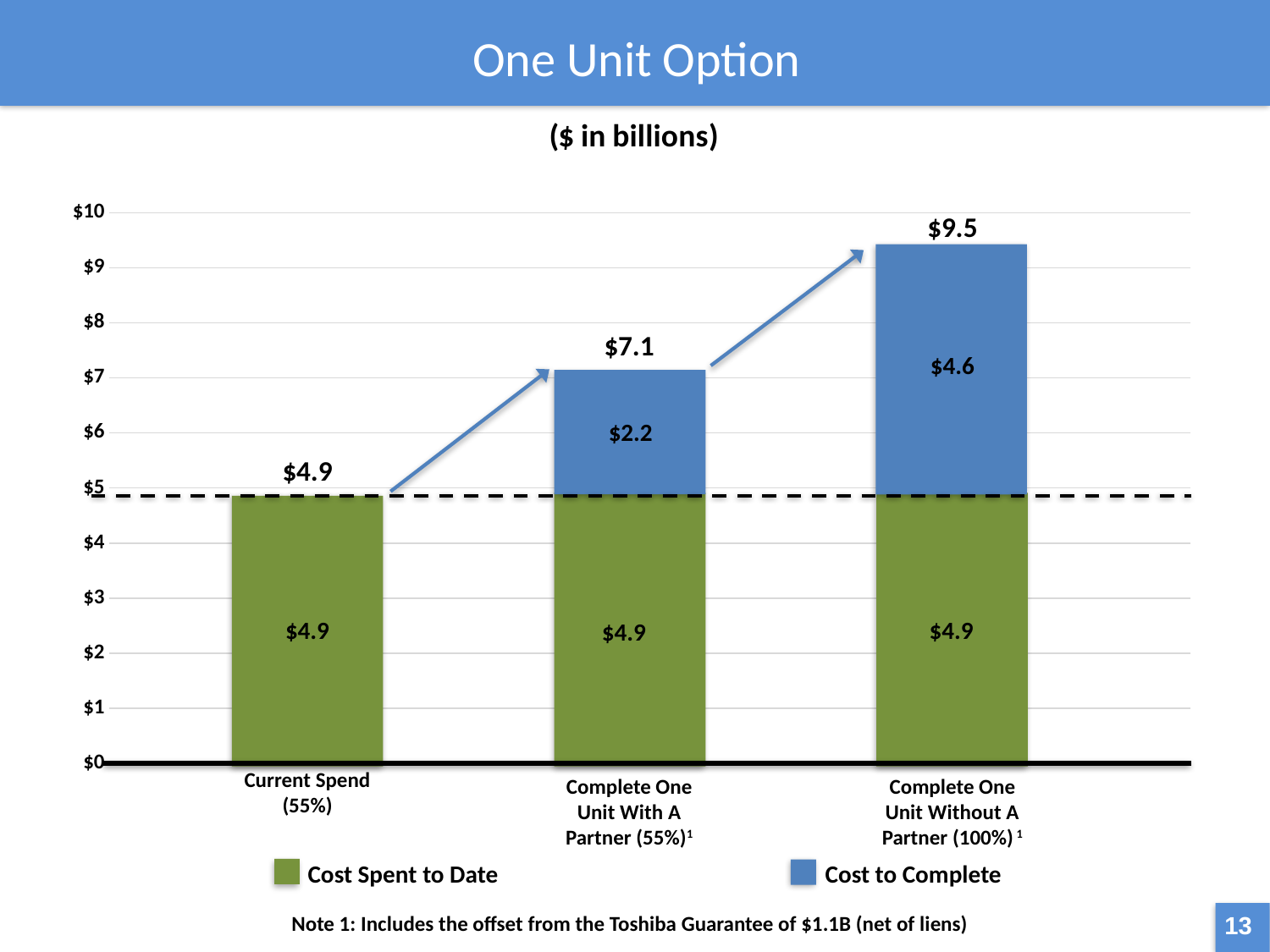
What is the Cost Spent to Date value for Current Spend (55%)? $4.9 Which category has the lowest total? Current Spend (55%) Do the bar totals rise or fall from left to right along the x axis? Rise What kind of chart is shown? Stacked bar chart What is the total for the Complete One Unit Without A Partner (100%) bar? $9.5 How many series does the legend list? 2 What is the difference between the totals for Complete One Unit Without A Partner (100%) and Complete One Unit With A Partner (55%)? $2.4 Which category has the highest total? Complete One Unit Without A Partner (100%) Which is larger: the Cost to Complete for Complete One Unit With A Partner (55%) or for Complete One Unit Without A Partner (100%)? Complete One Unit Without A Partner (100%) How many categories are shown on the x axis? 3 What is the Cost to Complete value for Complete One Unit With A Partner (55%)? $2.2 What is the Cost to Complete value for Complete One Unit Without A Partner (100%)? $4.6